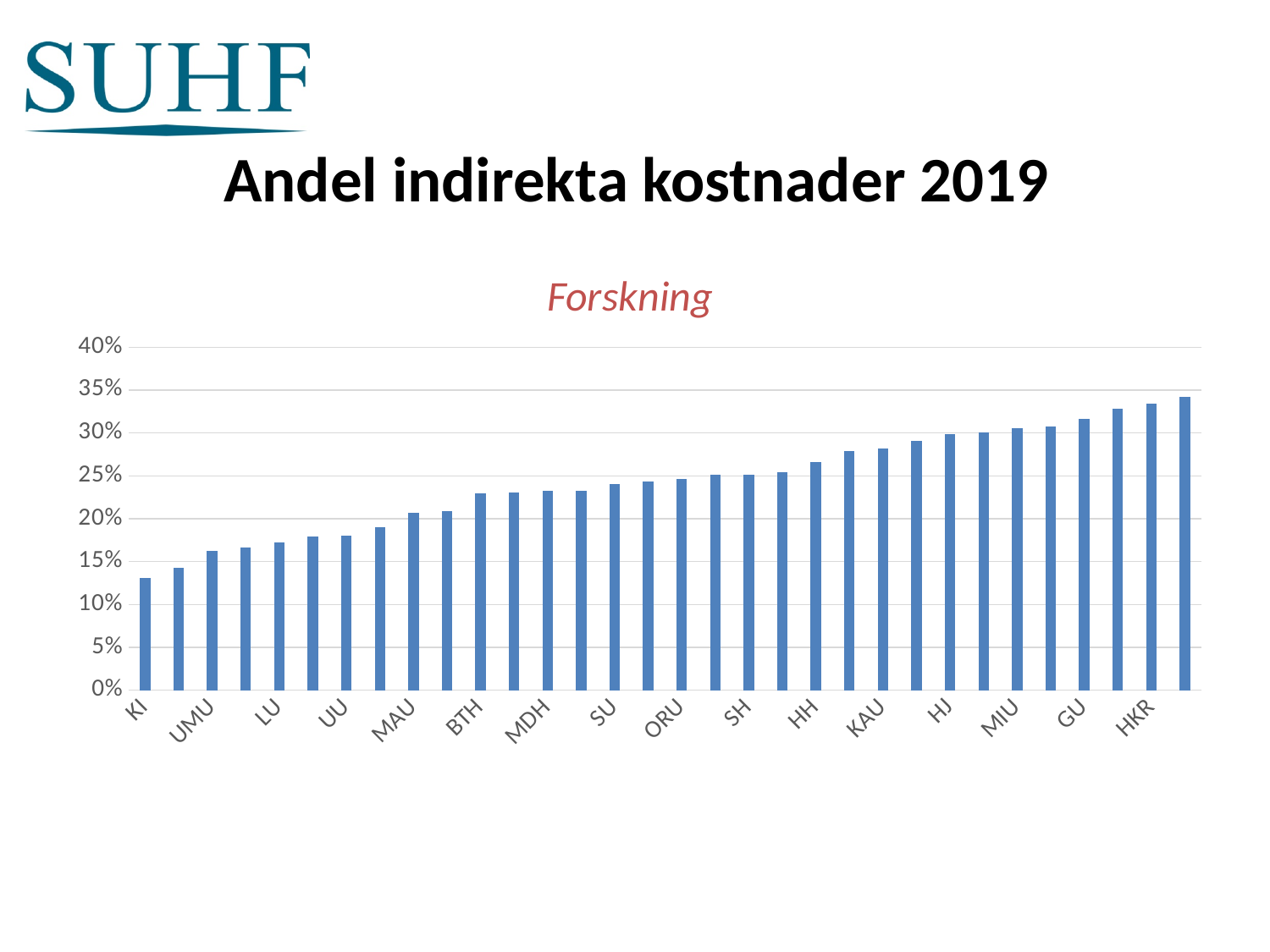
How many category labels are printed on the x axis? 16 Which has the larger value, UMU or GU? GU Do the bar values rise or fall from left to right along the x axis? rise Which labelled category has the lowest value? KI What is the title shown above the chart? Forskning Is the value for HKR greater or less than 30%? greater What is the main title of the slide? Andel indirekta kostnader 2019 Is the value for GU greater or less than 30%? greater What kind of chart is shown on the slide? bar chart Is the value for KI greater or less than 15%? less Which has the larger value, KI or HKR? HKR